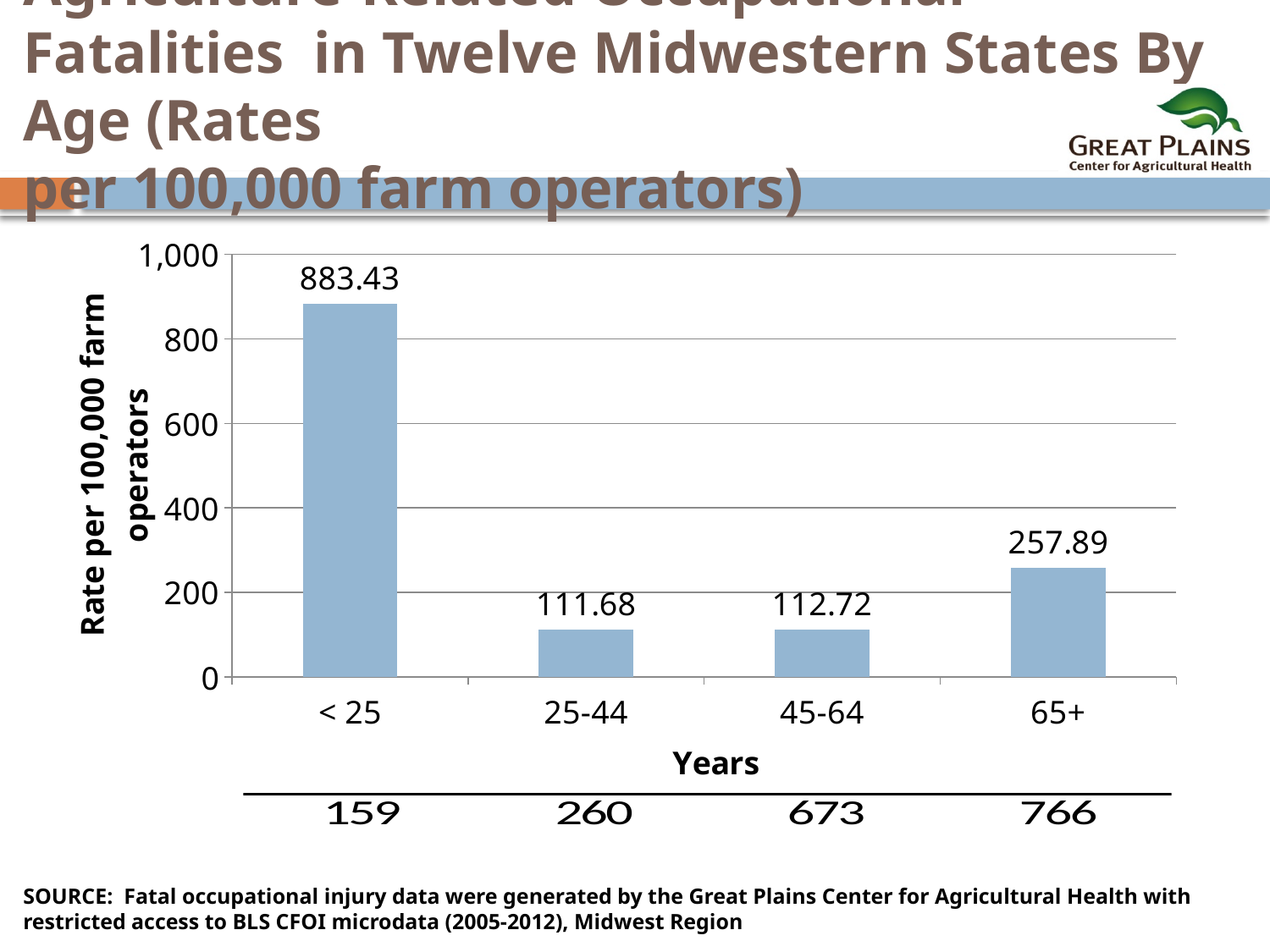
What type of chart is shown on the slide? bar chart How many age groups are shown in the chart? 4 What is the fatality rate per 100,000 farm operators for the 45-64 age group? 112.72 Is the fatality rate for the 65+ age group greater or less than 400? less What is the label of the vertical axis of the chart? Rate per 100,000 farm operators What is the difference between the fatality rates for the 65+ and 25-44 age groups? 146.21 What is the difference between the fatality rates for the < 25 and 65+ age groups? 625.54 Which age group has the lowest fatality rate? 25-44 Which age group has the highest fatality rate? < 25 What is the fatality rate per 100,000 farm operators for the 65+ age group? 257.89 What is the fatality rate per 100,000 farm operators for the < 25 age group? 883.43 What is the fatality rate per 100,000 farm operators for the 25-44 age group? 111.68